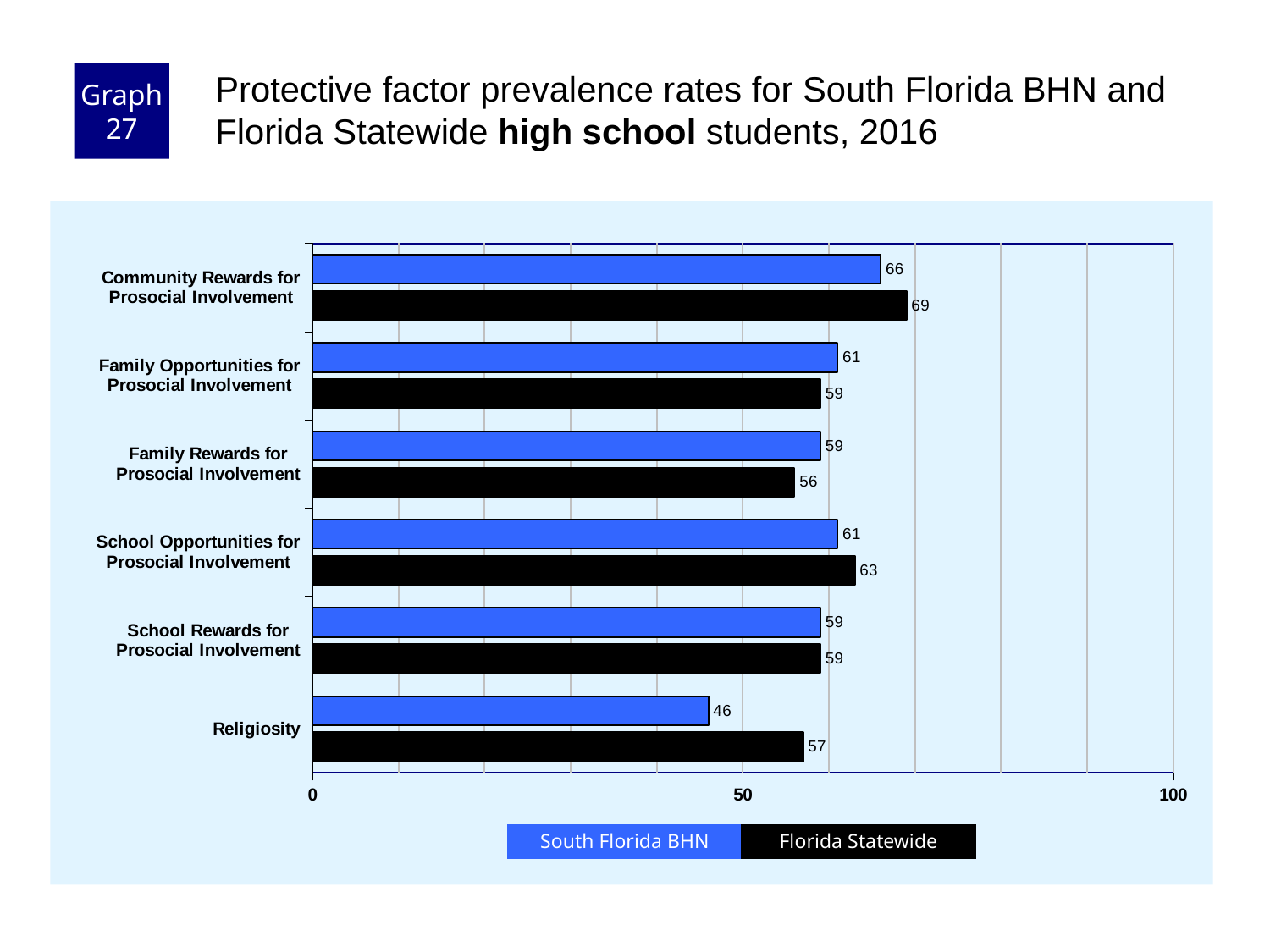
For School Opportunities for Prosocial Involvement, which is larger: South Florida BHN or Florida Statewide? Florida Statewide Which category has the lowest South Florida BHN value? Religiosity Is the South Florida BHN value for Religiosity greater or less than 50? less What is the difference between the Florida Statewide and South Florida BHN values for Religiosity? 11 What is the difference between the Florida Statewide and South Florida BHN values for Community Rewards for Prosocial Involvement? 3 How many series does the legend list? 2 Which category has the highest Florida Statewide value? Community Rewards for Prosocial Involvement What is the Florida Statewide value for Family Rewards for Prosocial Involvement? 56 What is the South Florida BHN value for Community Rewards for Prosocial Involvement? 66 What kind of chart is shown on the slide? bar chart What is the Florida Statewide value for Religiosity? 57 How many categories are shown on the chart? 6